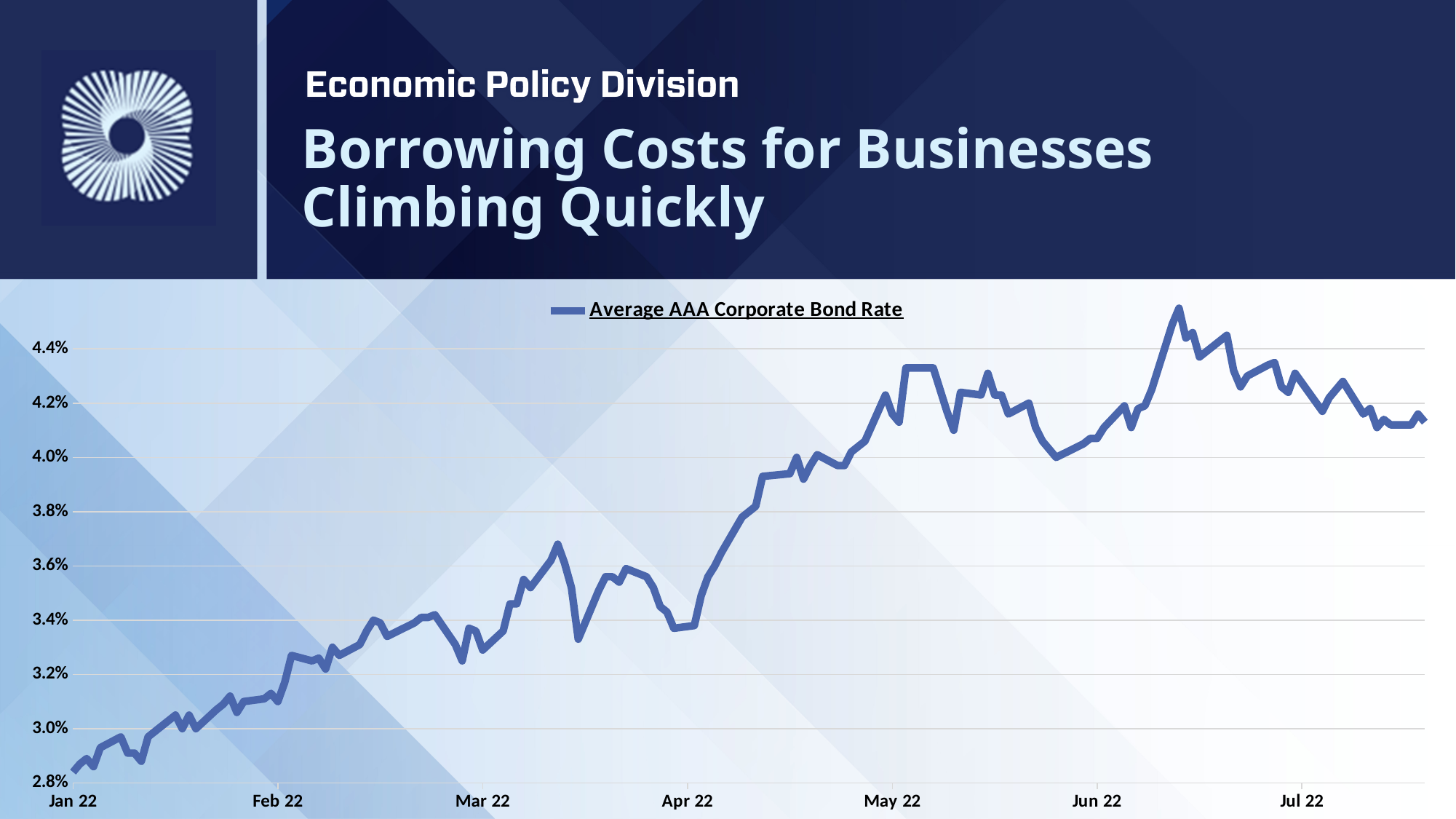
Is the Average AAA Corporate Bond Rate at the start of Jan 22 greater or less than 3.0%? less Is the highest point of the Average AAA Corporate Bond Rate greater or less than 4.4%? greater What is the title of the slide containing the chart? Borrowing Costs for Businesses Climbing Quickly Between which two x-axis labels does the Average AAA Corporate Bond Rate reach its highest point? Jun 22 and Jul 22 Is the Average AAA Corporate Bond Rate at Apr 22 greater or less than 3.6%? less How many month labels are shown on the x axis? 7 Overall, does the Average AAA Corporate Bond Rate rise or fall from Jan 22 to Jul 22? rise How many series does the legend list? 1 What is the name of the series shown in the legend? Average AAA Corporate Bond Rate What kind of chart is shown on the slide? line chart